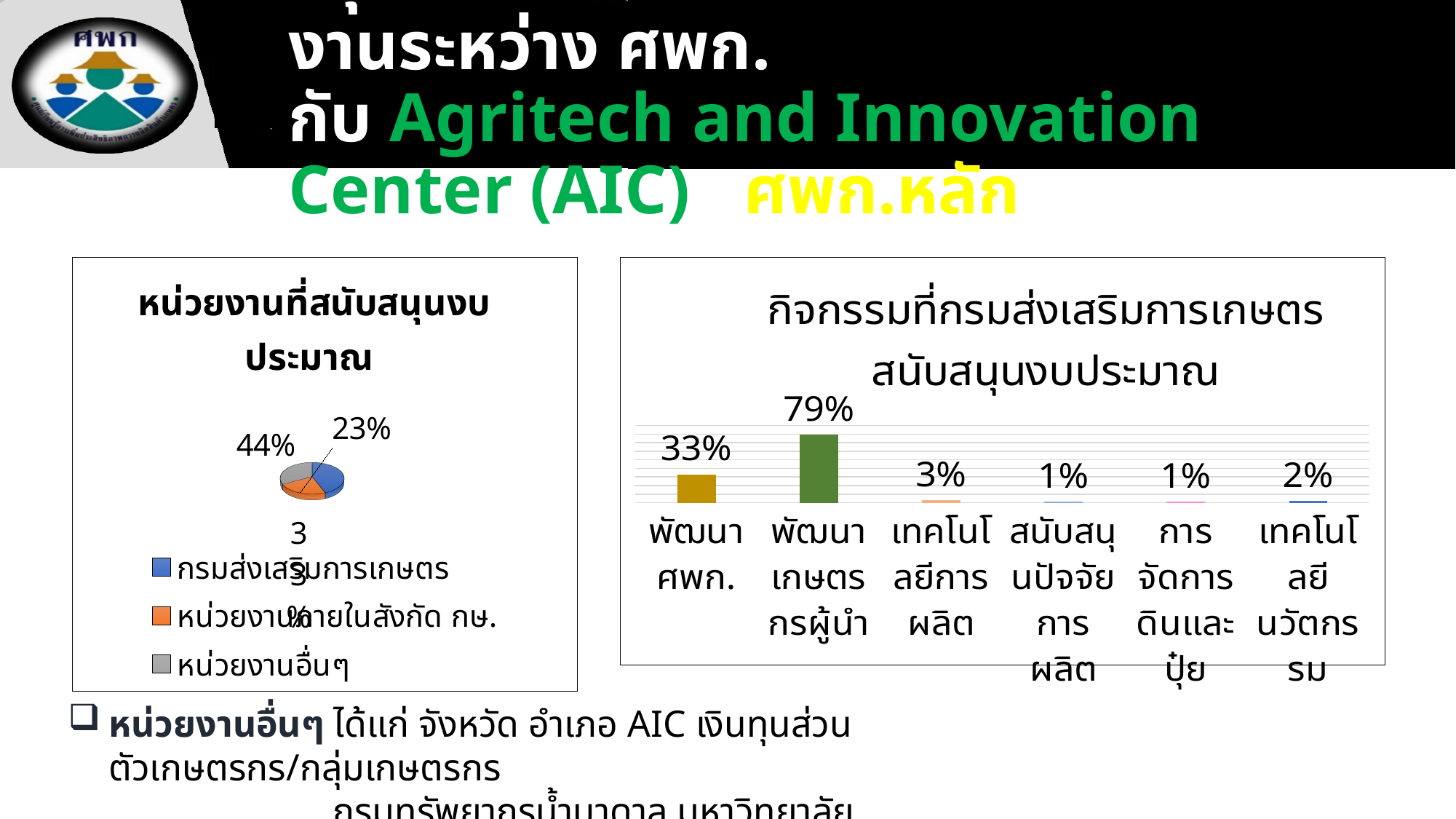
In the right-hand bar chart, what is the value for เทคโนโลยีนวัตกรรม? 2% How many entries does the legend of the left-hand pie chart list? 3 What kind of chart is the chart on the left of the slide (หน่วยงานที่สนับสนุนงบประมาณ)? pie chart In the left-hand pie chart, what is the largest percentage shown on a slice? 44% In the right-hand bar chart, what is the value for การจัดการดินและปุ๋ย? 1% In the right-hand bar chart, what is the value for พัฒนา ศพก.? 33% In the right-hand bar chart, what is the value for พัฒนาเกษตรกรผู้นำ? 79% In the right-hand bar chart, which category has the highest value? พัฒนาเกษตรกรผู้นำ In the right-hand bar chart, which is larger: เทคโนโลยีการผลิต or เทคโนโลยีนวัตกรรม? เทคโนโลยีการผลิต How many categories are shown in the right-hand bar chart? 6 In the right-hand bar chart, what is the difference between the values for พัฒนาเกษตรกรผู้นำ and พัฒนา ศพก.? 46% What kind of chart is the chart on the right of the slide (กิจกรรมที่กรมส่งเสริมการเกษตรสนับสนุนงบประมาณ)? bar chart